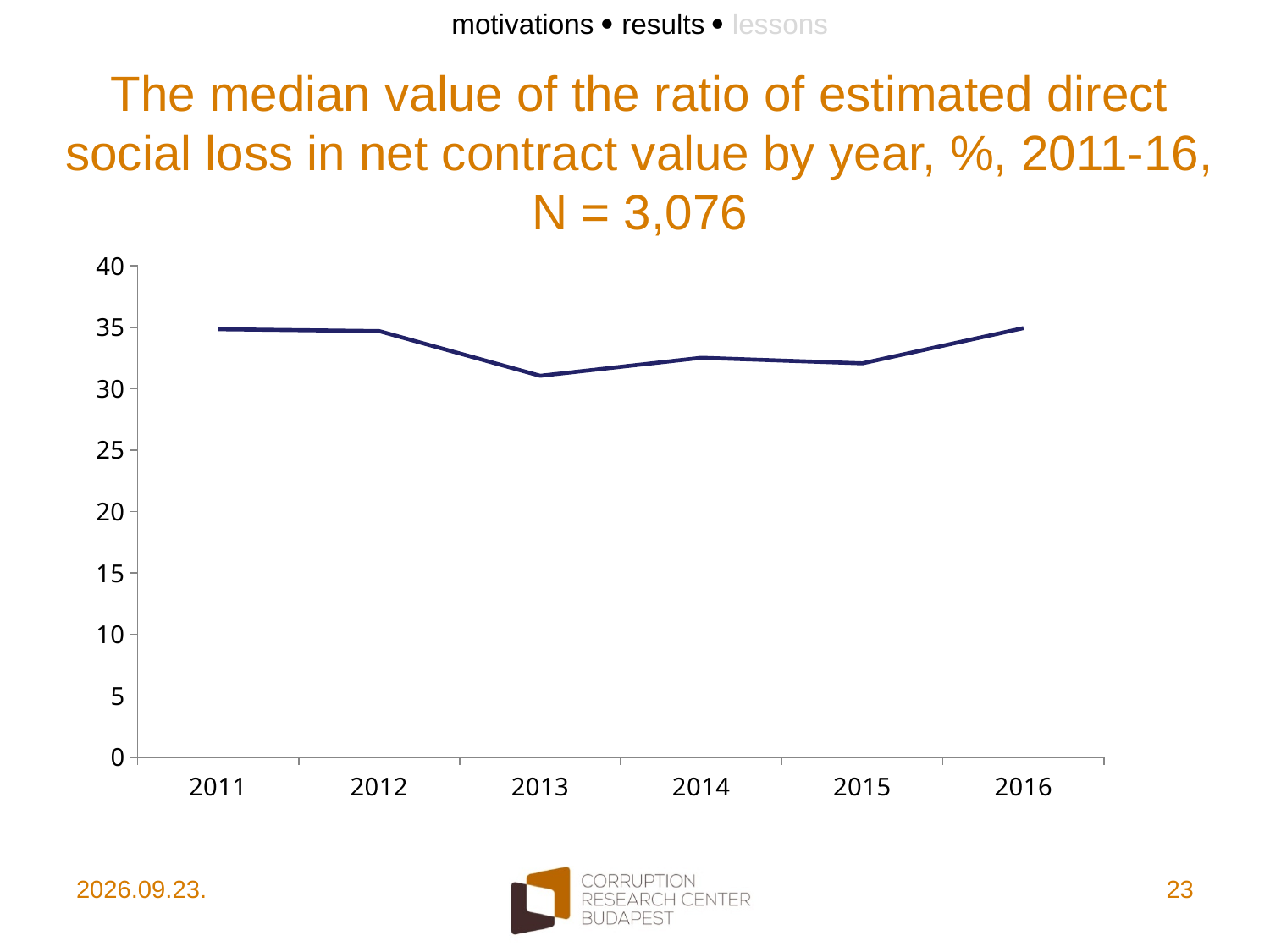
Is the value for 2013 greater or less than 30? greater Is the value for 2016 greater or less than 40? less How many years are plotted on the x axis of the chart? 6 Which is larger, the value for 2011 or the value for 2013? 2011 Which is larger, the value for 2015 or the value for 2016? 2016 What kind of chart is shown on the slide? line chart Does the line rise or fall from 2015 to 2016? rise Does the line rise or fall from 2012 to 2013? fall Is the value for 2011 greater or less than 30? greater What sample size N is stated in the chart title? N = 3,076 Which year has the lowest median value in the chart? 2013